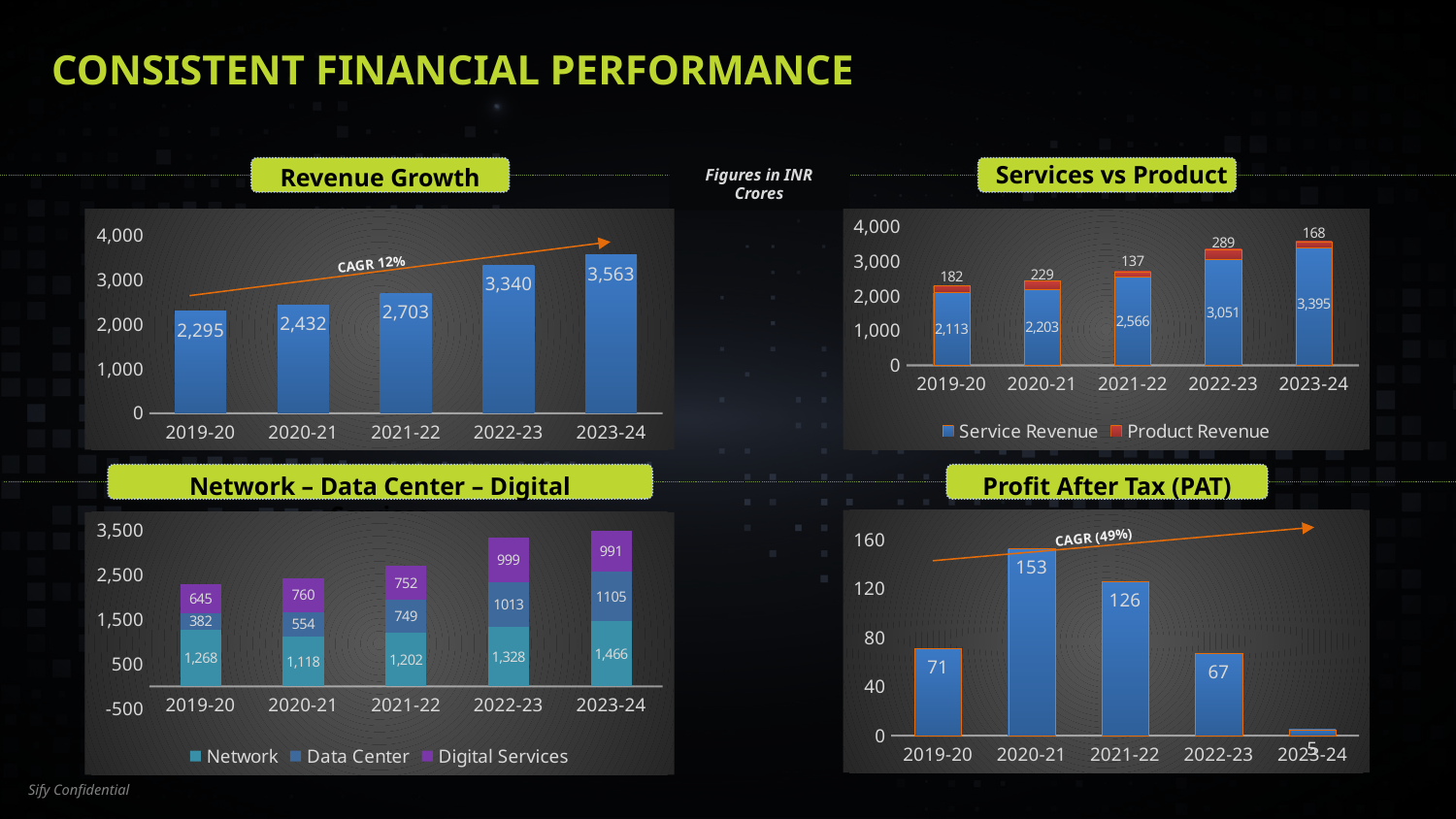
In the Services vs Product chart, how many series does the legend list? 2 In the Network – Data Center – Digital chart, is the Digital Services value for 2022-23 or 2023-24 larger? 2022-23 In the Services vs Product chart, which year has the lowest Product Revenue? 2021-22 In the Network – Data Center – Digital chart, what is the Data Center value for 2021-22? 749 What kind of chart is the Profit After Tax (PAT) chart? bar chart In the Profit After Tax (PAT) chart, which year has the highest value? 2020-21 In the Revenue Growth chart, what is the value for 2023-24? 3,563 In the Services vs Product chart, what is the total of the stacked bar for 2023-24? 3,563 In the Network – Data Center – Digital chart, which year has the highest Network value? 2023-24 In the Revenue Growth chart, what is the difference between the 2022-23 and 2019-20 values? 1,045 In the Revenue Growth chart, do the values rise or fall from 2019-20 to 2023-24? rise In the Services vs Product chart, what is the Product Revenue value for 2022-23? 289